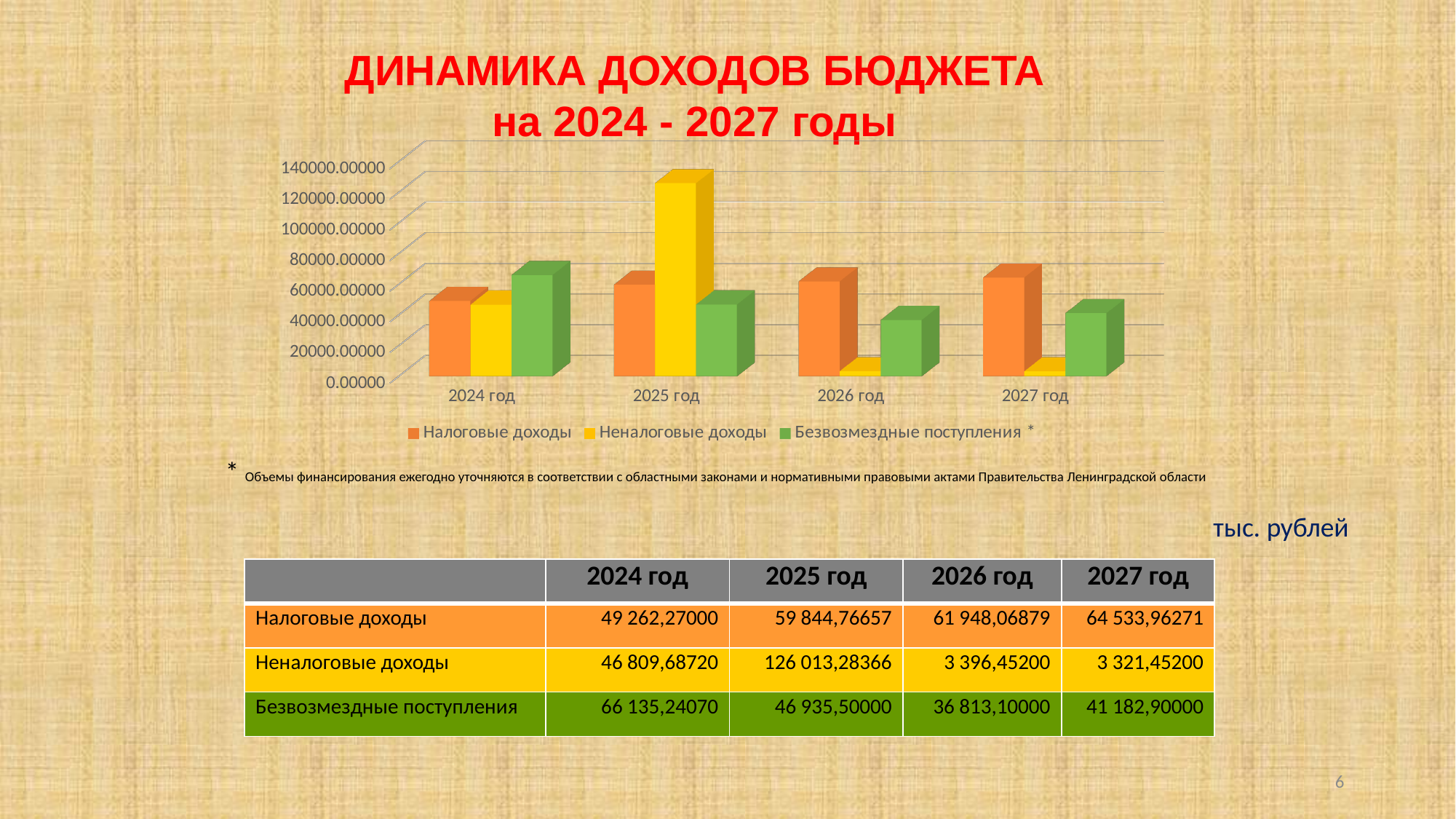
Which is larger in 2024 год: Налоговые доходы or Безвозмездные поступления? Безвозмездные поступления How many year categories are shown on the x axis of the chart? 4 What is the value of Налоговые доходы for 2027 год? 64 533,96271 What colour represents Неналоговые доходы in the chart? yellow Which year has the highest value for Неналоговые доходы? 2025 год Is the value for Неналоговые доходы in 2025 год greater or less than 120000? greater How many series does the chart legend list? 3 Do the values for Налоговые доходы rise or fall from 2024 год to 2027 год? rise What kind of chart is shown on the slide? bar chart Which year has the lowest value for Безвозмездные поступления? 2026 год What is the value of Неналоговые доходы for 2025 год? 126 013,28366 What is the value of Безвозмездные поступления for 2024 год? 66 135,24070